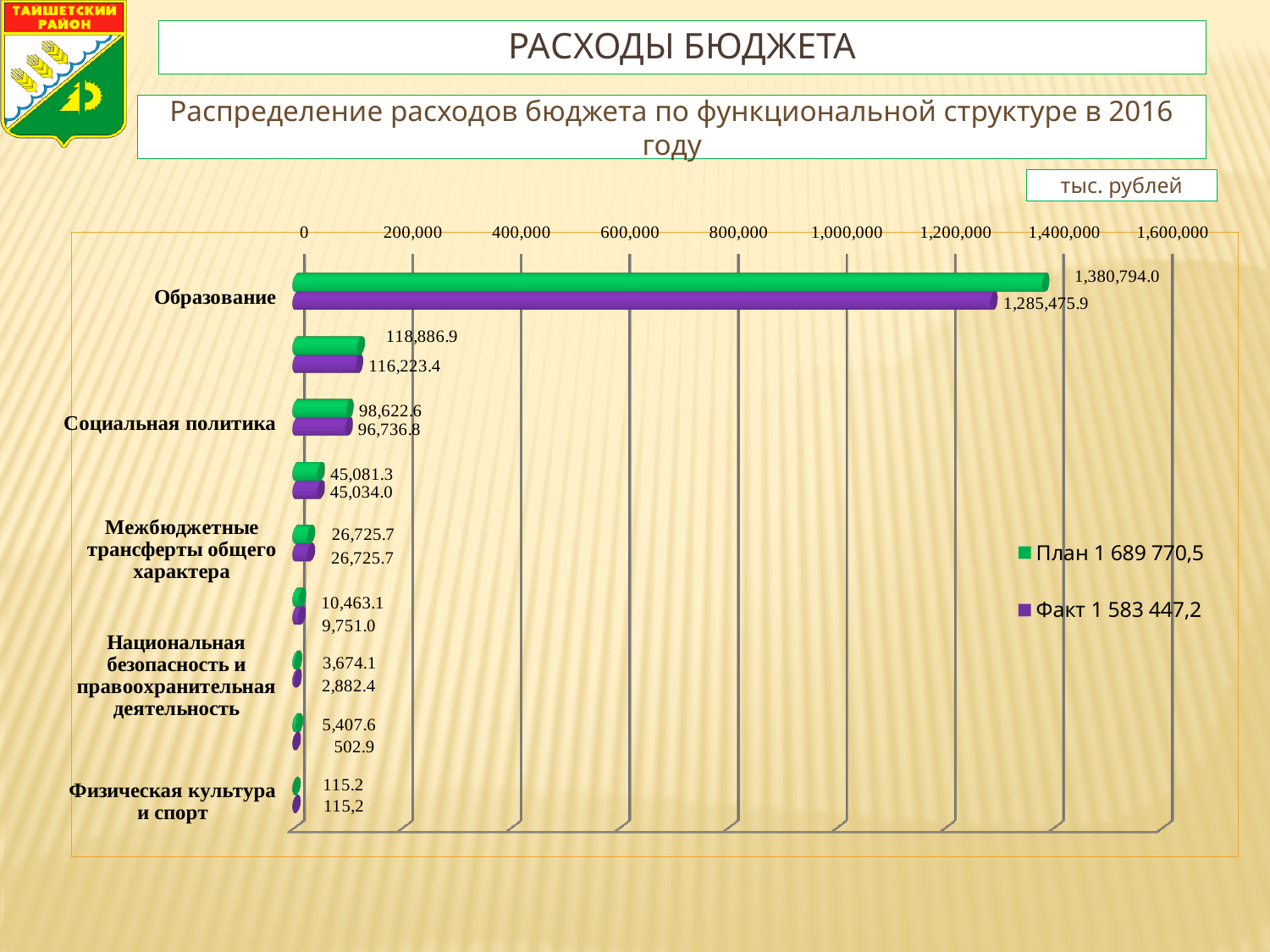
What total is shown next to the Факт entry in the legend? 1 583 447,2 What is the difference between the План and Факт values for Образование? 95,318.1 What is the Факт value for Национальная безопасность и правоохранительная деятельность? 2,882.4 Which labeled category has the lowest Факт value? Физическая культура и спорт What is the Факт value for Образование? 1,285,475.9 Which category has the highest План value? Образование For Социальная политика, which is larger: the План value or the Факт value? План What kind of chart is shown on the slide? bar chart What is the Факт value for Межбюджетные трансферты общего характера? 26,725.7 How many series does the legend list? 2 What is the План value for Социальная политика? 98,622.6 What is the План value for Образование? 1,380,794.0